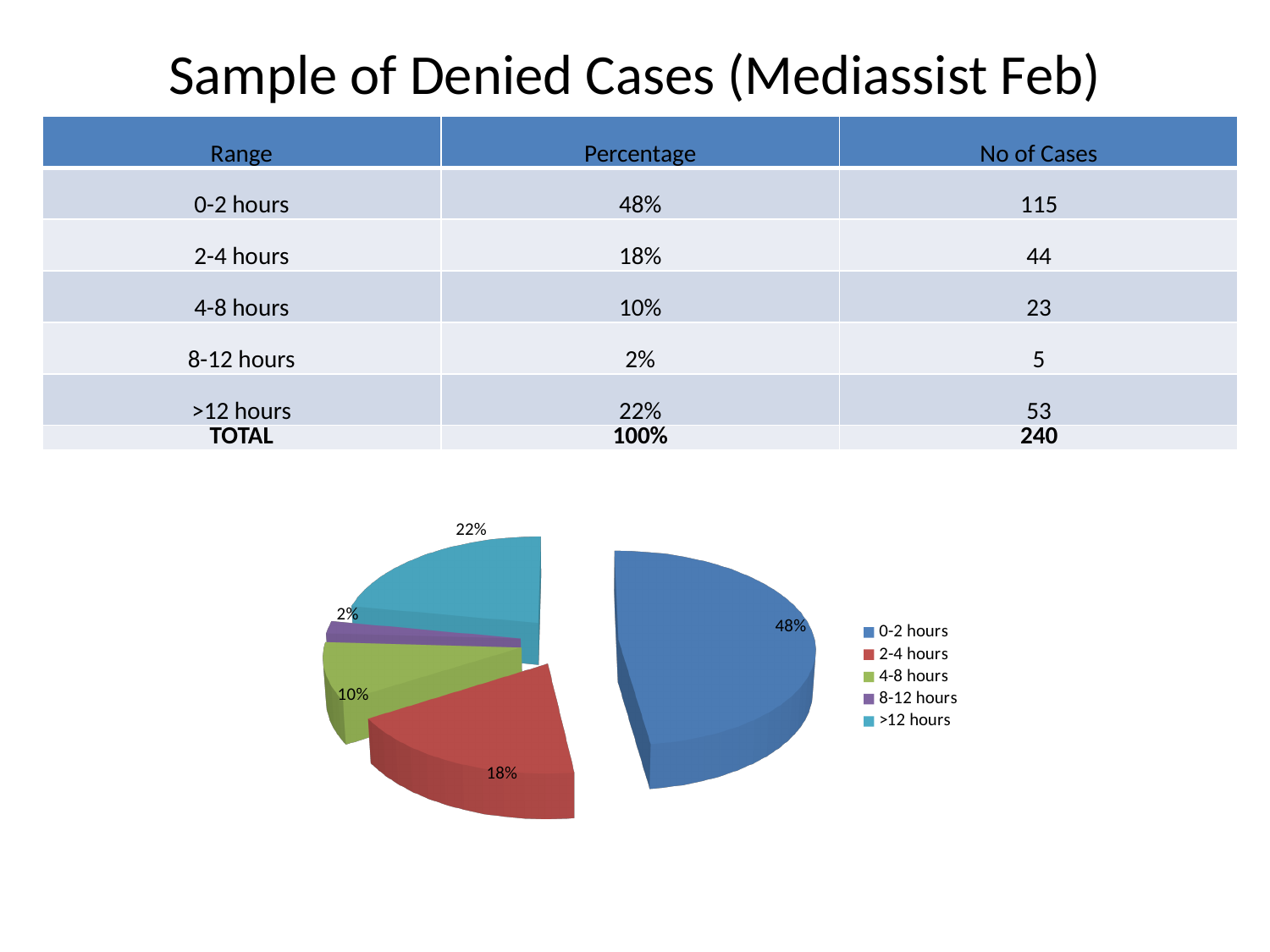
What kind of chart is shown on the slide? pie chart Which slice is larger, 2-4 hours or 4-8 hours? 2-4 hours What share of the pie does the >12 hours slice represent? 22% What share of the pie does the 8-12 hours slice represent? 2% How many slices does the pie chart have? 5 How many entries does the legend list? 5 What is the difference in percentage points between the 0-2 hours slice and the >12 hours slice? 26% Which category has the largest slice of the pie? 0-2 hours What colour is the 0-2 hours slice in the pie chart? blue What share of the pie does the 0-2 hours slice represent? 48% Which category has the smallest slice of the pie? 8-12 hours